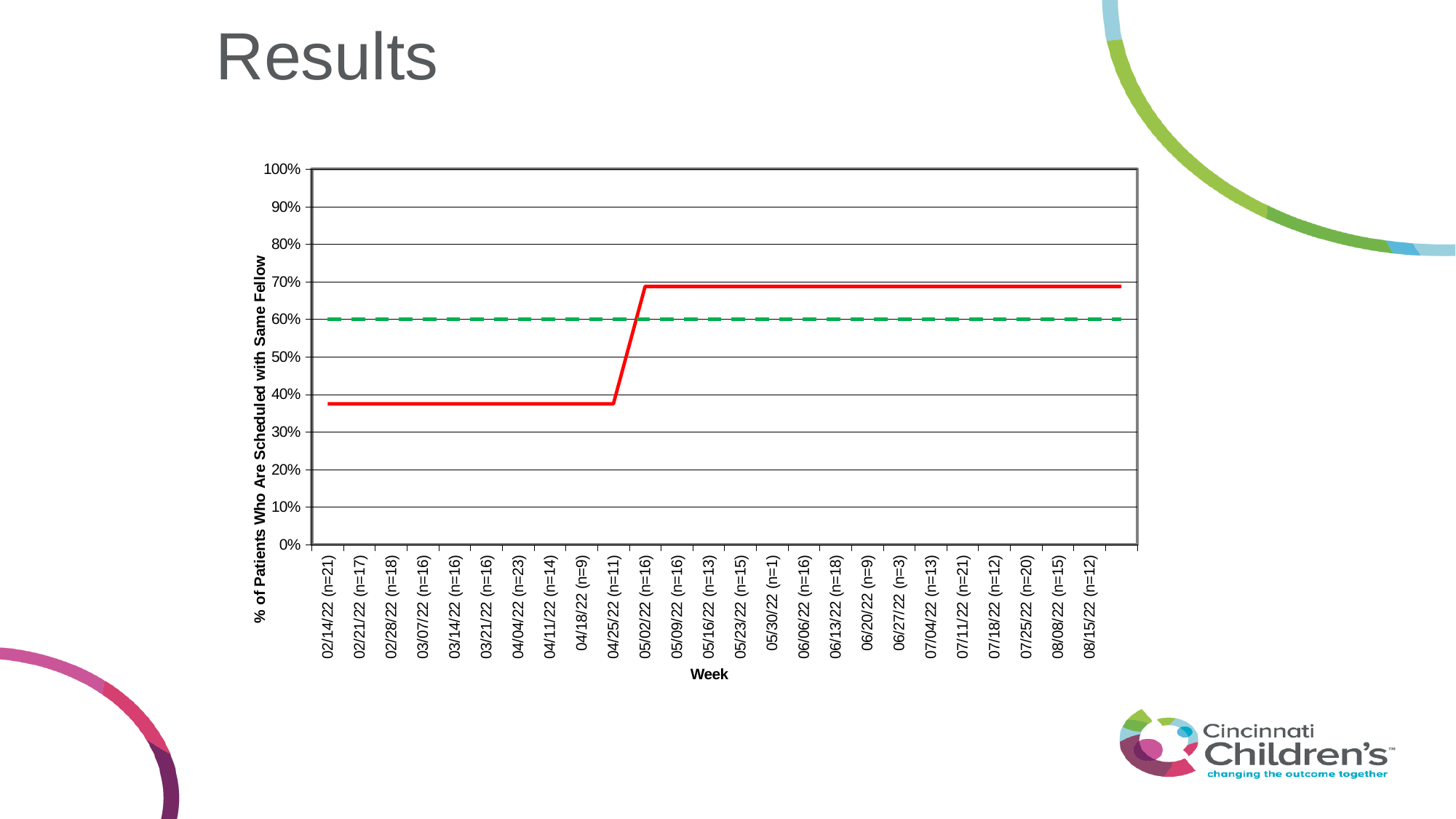
What is the title of the x axis? Week What kind of chart is shown on the slide? line chart Is the value of the red line for the week of 05/02/22 greater or less than 60%? greater At what level does the green dashed line sit on the y axis? 60% What is the n shown for the week of 05/30/22? n=1 How many weeks are plotted along the x axis? 25 Is the red line higher for the week of 04/25/22 or the week of 05/09/22? 05/09/22 Is the value of the red line for the week of 02/14/22 greater or less than 40%? less Does the red line rise or fall between the week of 04/25/22 and the week of 05/02/22? rise What is the n shown for the week of 04/04/22? n=23 What is the title of the y axis? % of Patients Who Are Scheduled with Same Fellow